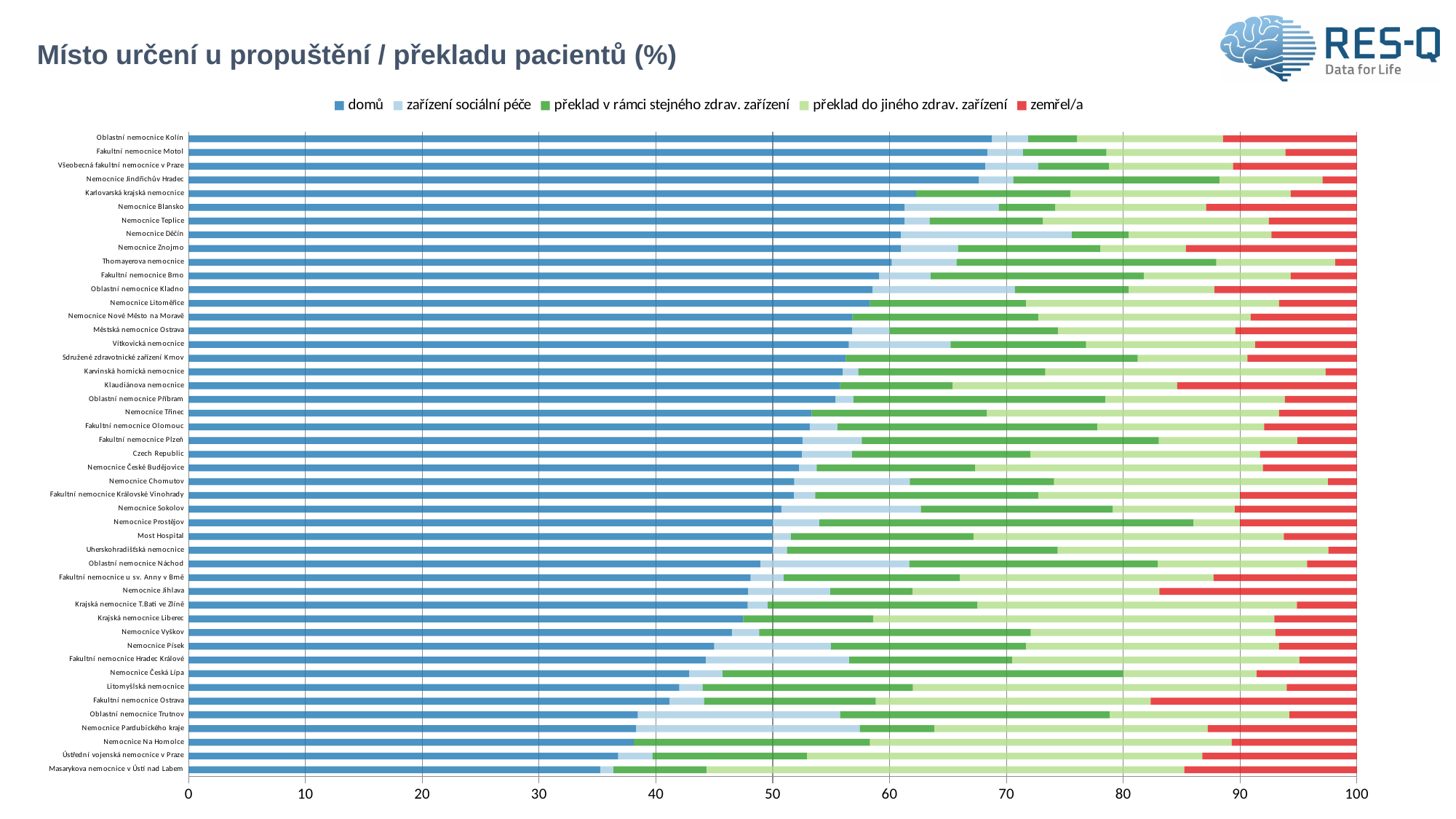
Which series is shown in red in the legend? zemřel/a How many series does the legend list? 5 Is the 'domů' value for Masarykova nemocnice v Ústí nad Labem greater or less than 40? less What is the title of the chart? Místo určení u propuštění / překladu pacientů (%) Which has a larger 'domů' share: Oblastní nemocnice Kolín or Masarykova nemocnice v Ústí nad Labem? Oblastní nemocnice Kolín Which has a larger 'zemřel/a' share: Nemocnice Jihlava or Nemocnice Jindřichův Hradec? Nemocnice Jihlava What kind of chart is shown on the slide? Stacked horizontal bar chart Is the 'domů' value for Oblastní nemocnice Kolín greater or less than 60? greater Is the 'domů' value for Fakultní nemocnice Ostrava greater or less than 50? less How many hospitals (categories) are plotted on the chart? 47 Do the 'domů' values rise or fall going from the top bar to the bottom bar? fall